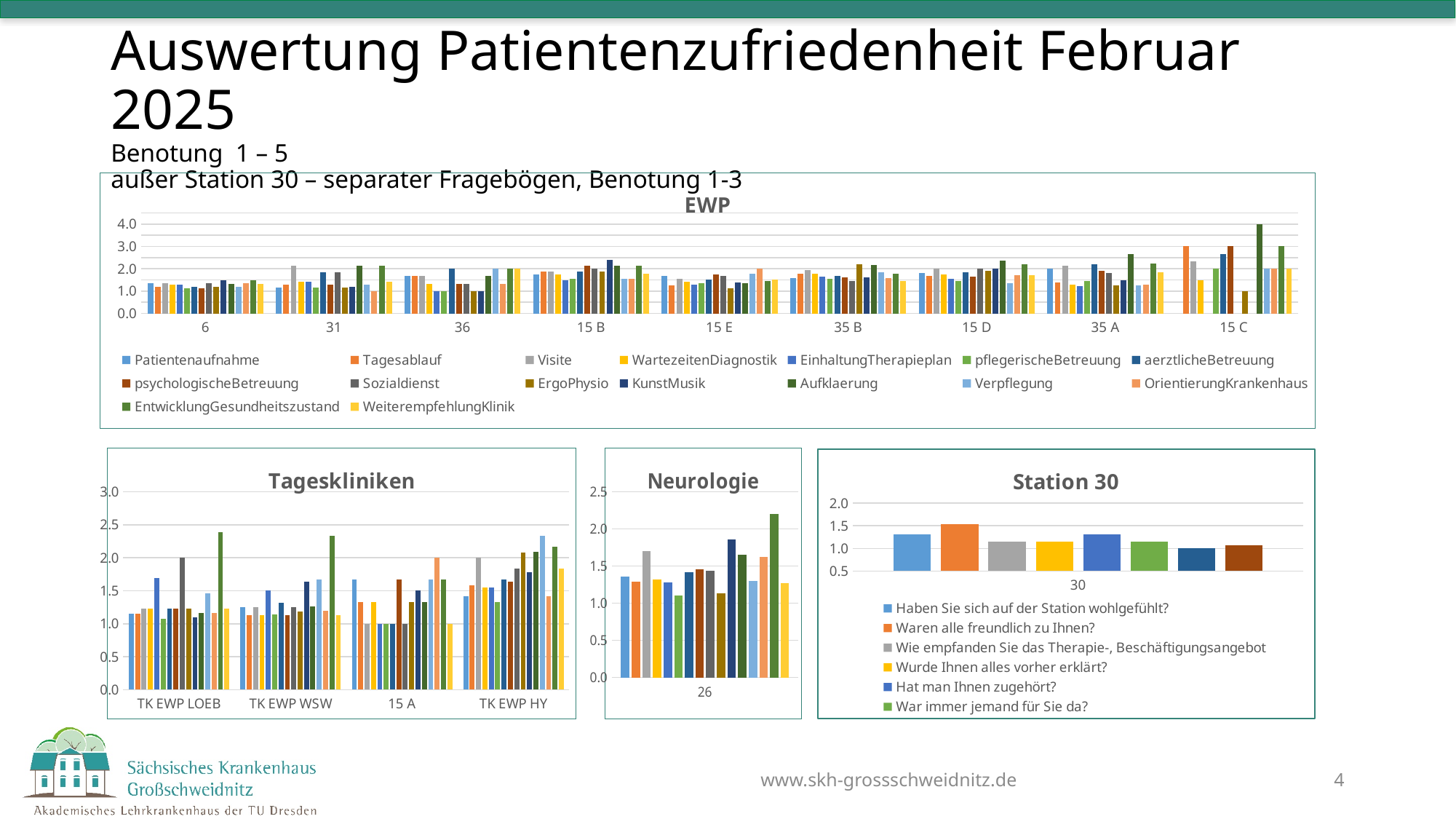
In the Station 30 chart, is the value for 'Haben Sie sich auf der Station wohlgefühlt?' greater or less than 1.5? less In the Neurologie chart, is the tallest bar greater or less than 2.0? greater In the Tageskliniken chart, is the tallest bar for TK EWP LOEB greater or less than 2.0? greater What type of chart is the EWP chart? bar chart In the Station 30 chart, which legend entry has the highest value? Waren alle freundlich zu Ihnen? In the EWP chart, which category contains the tallest bar? 15 C How many series does the legend of the EWP chart list? 16 How many categories are shown on the x axis of the EWP chart? 9 How many categories are shown on the x axis of the Tageskliniken chart? 4 What is the category label on the x axis of the Neurologie chart? 26 How many series does the legend of the Station 30 chart list? 6